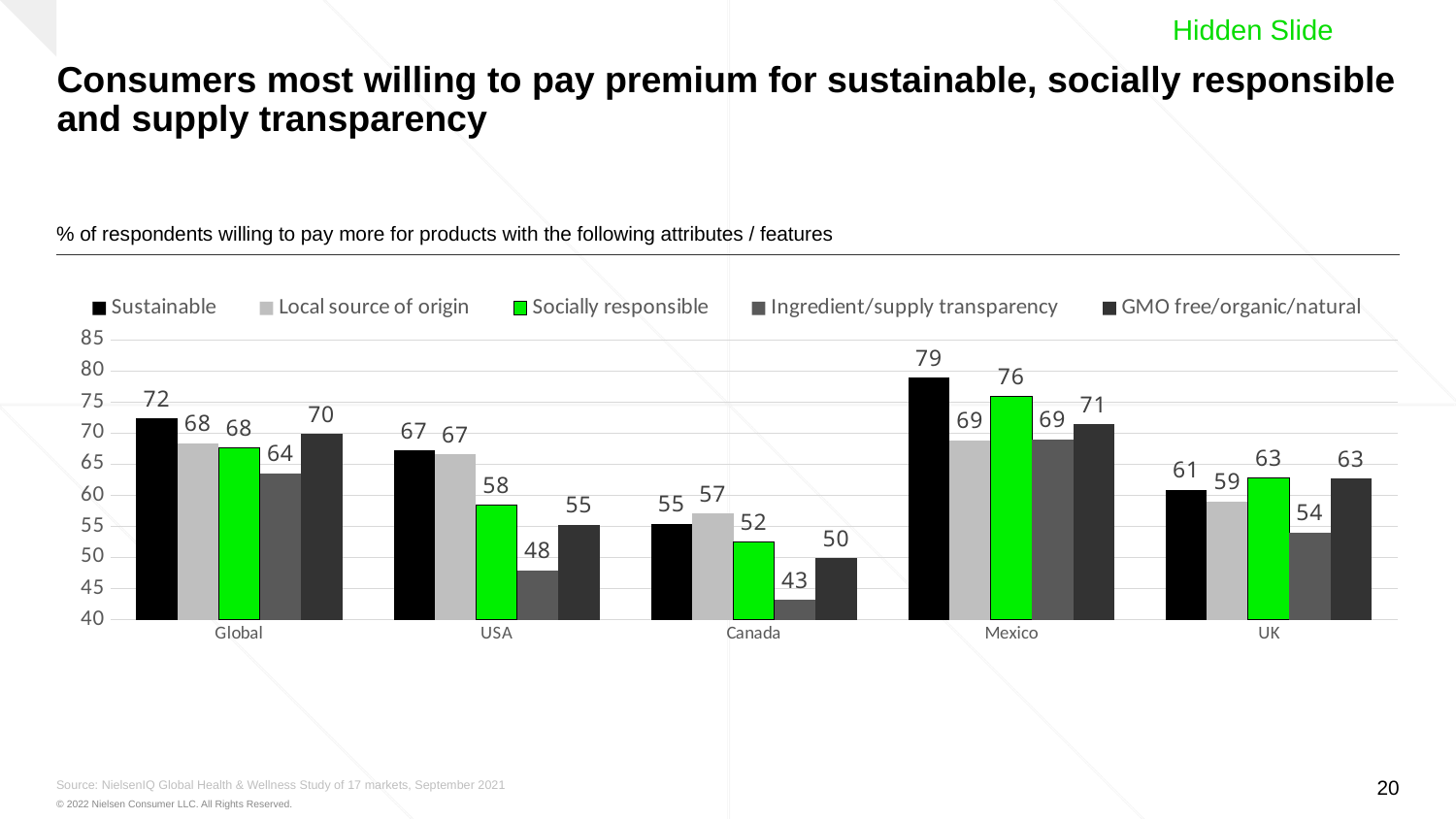
Which colour represents the Socially responsible series? Green What is the value for Sustainable in Mexico? 79 What is the value for Ingredient/supply transparency in Canada? 43 Which market has the highest value for Sustainable? Mexico Which is larger in the USA: Local source of origin or Socially responsible? Local source of origin What is the difference between the Sustainable value for Mexico and the Sustainable value for Canada? 24 Which market has the lowest value for Ingredient/supply transparency? Canada How many series does the legend list? 5 What is the value for GMO free/organic/natural for Global? 70 What kind of chart is shown on the slide? Bar chart What is the value for Socially responsible in the UK? 63 How many markets are shown on the x axis? 5